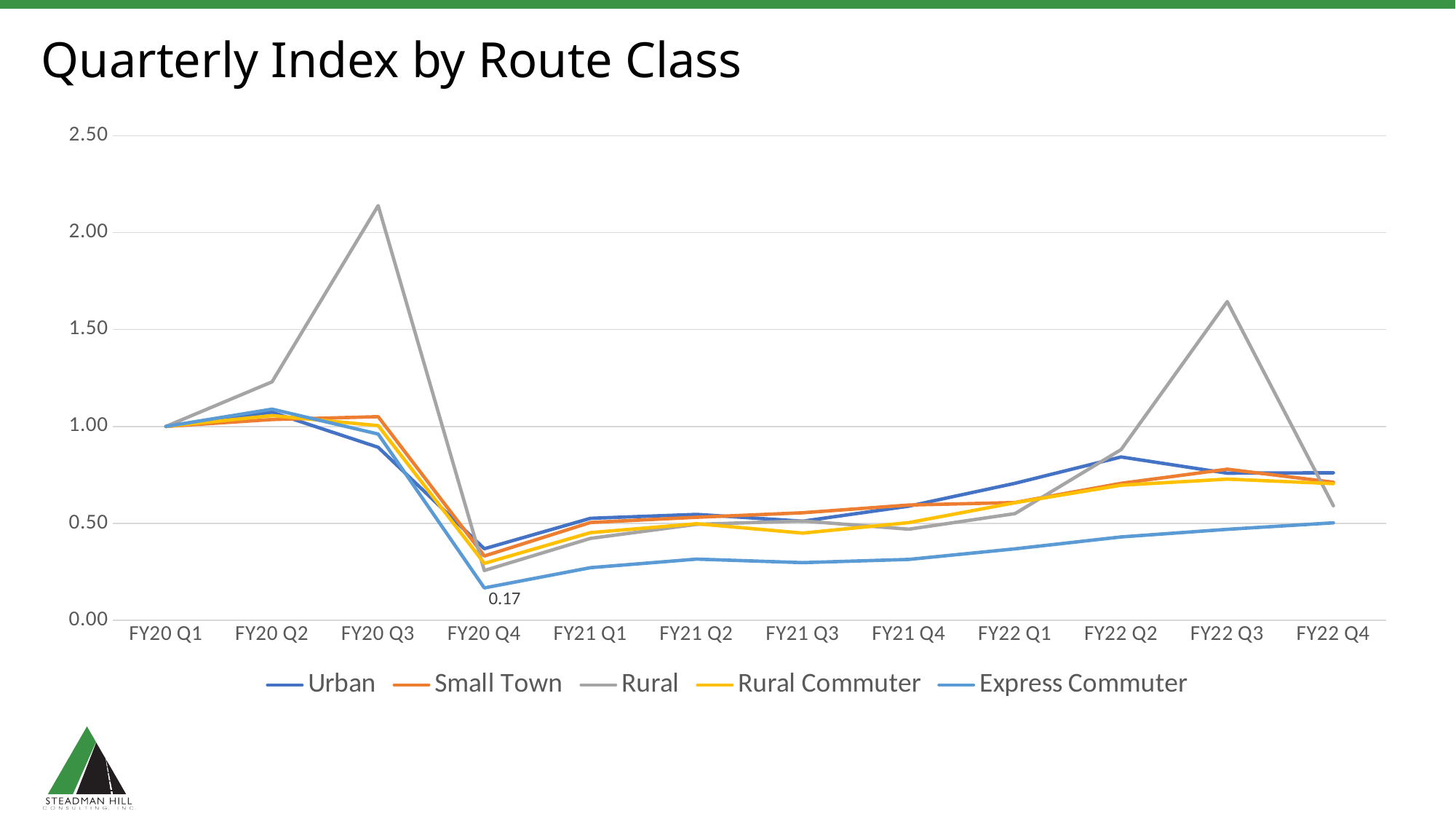
Is the value for Rural in FY22 Q3 greater or less than 1.50? greater Is the value for Rural in FY20 Q3 greater or less than 2.00? greater Is the value for Urban in FY20 Q4 greater or less than 0.50? less What kind of chart is shown on the slide? line chart What is the value for Express Commuter in FY20 Q4? 0.17 In which quarter does the Rural series reach its highest value? FY20 Q3 Which series has the highest value in FY20 Q3? Rural Does the Express Commuter series rise or fall from FY20 Q4 to FY22 Q4? rise Which series has the lowest value in FY22 Q4? Express Commuter In FY22 Q3, which is larger: the value for Rural or the value for Express Commuter? Rural How many series does the legend list? 5 How many quarters are plotted along the x axis? 12